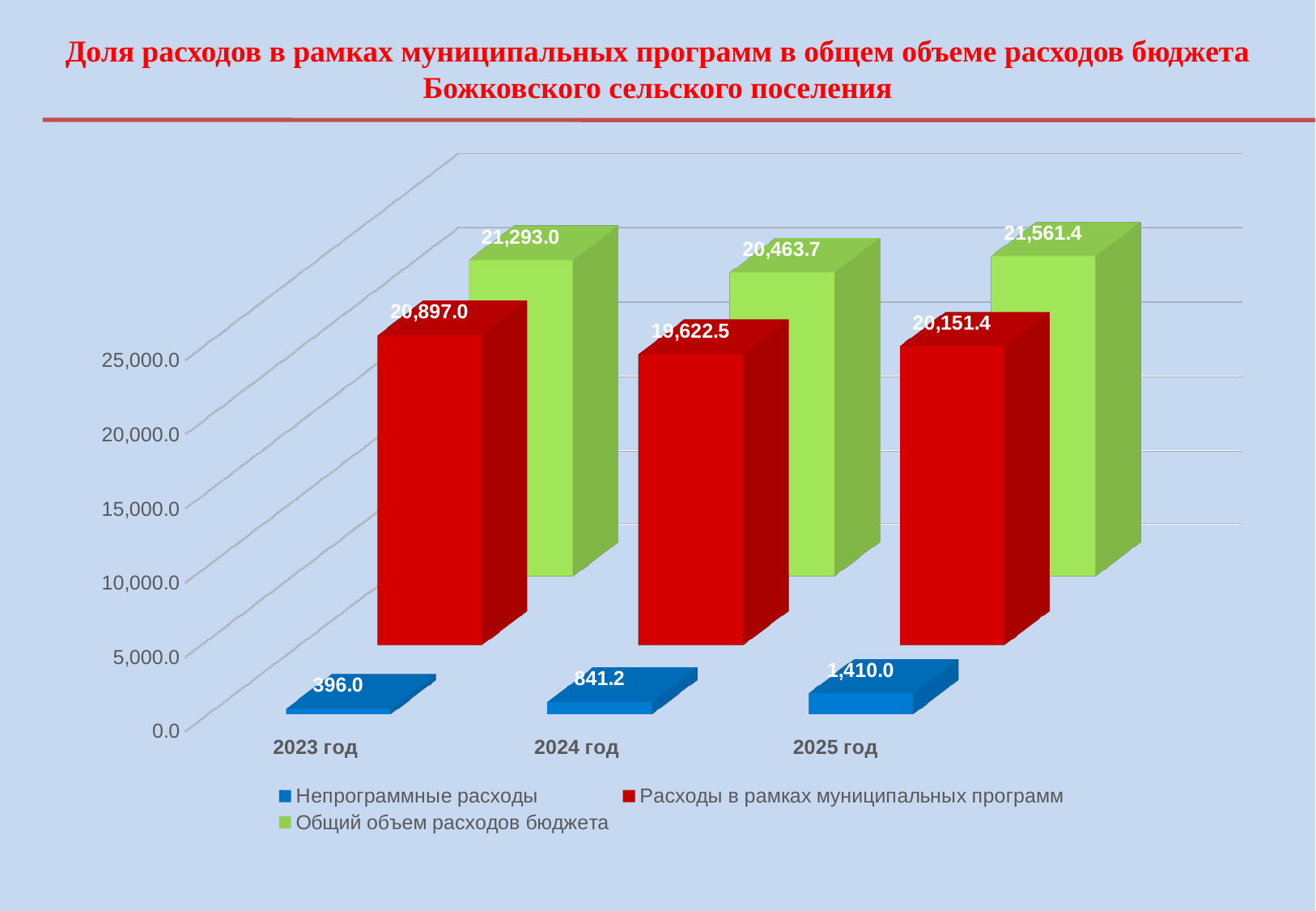
In which year is Расходы в рамках муниципальных программ the lowest? 2024 год What is the difference between Общий объем расходов бюджета and Расходы в рамках муниципальных программ for 2024 год? 841.2 Do the values of Непрограммные расходы rise or fall from 2023 год to 2025 год? rise What kind of chart is shown on the slide? bar chart Which colour represents Общий объем расходов бюджета in the legend? green In which year is Непрограммные расходы the highest? 2025 год What is the value of Расходы в рамках муниципальных программ for 2023 год? 20,897.0 How many series does the legend list? 3 How many years are shown on the x axis? 3 Which is larger: Общий объем расходов бюджета for 2023 год or for 2025 год? 2025 год What is the value of Общий объем расходов бюджета for 2025 год? 21,561.4 What is the value of Непрограммные расходы for 2024 год? 841.2